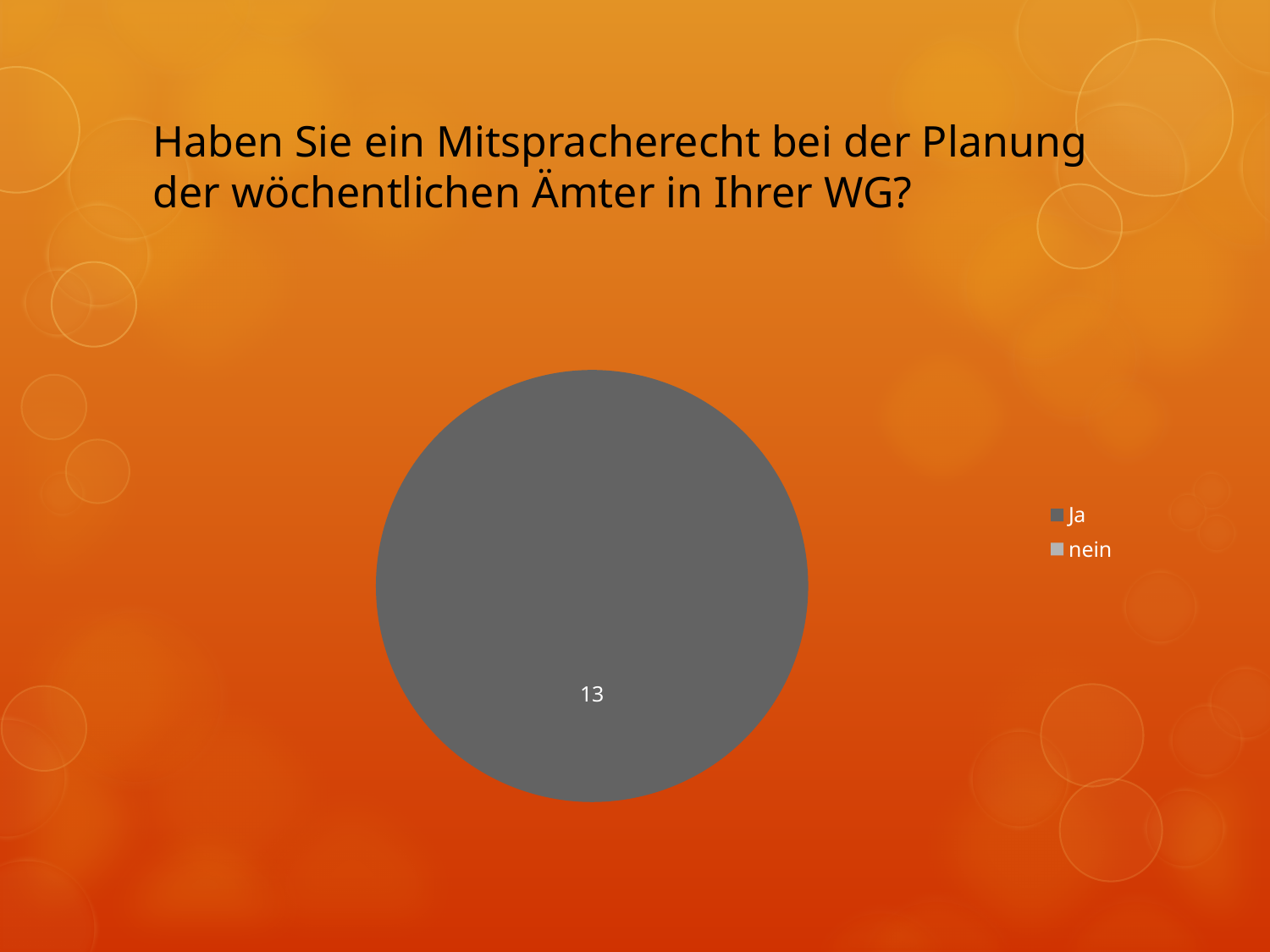
What are the two entries listed in the legend of the pie chart? Ja, nein Which category makes up the largest part of the pie chart? Ja What value is printed as the data label on the pie chart? 13 What kind of chart is shown on the slide? pie chart What question is written as the title above the pie chart? Haben Sie ein Mitspracherecht bei der Planung der wöchentlichen Ämter in Ihrer WG? How many entries does the legend of the pie chart list? 2 What is the value for Ja in the pie chart? 13 How many data labels are printed on the pie chart? 1